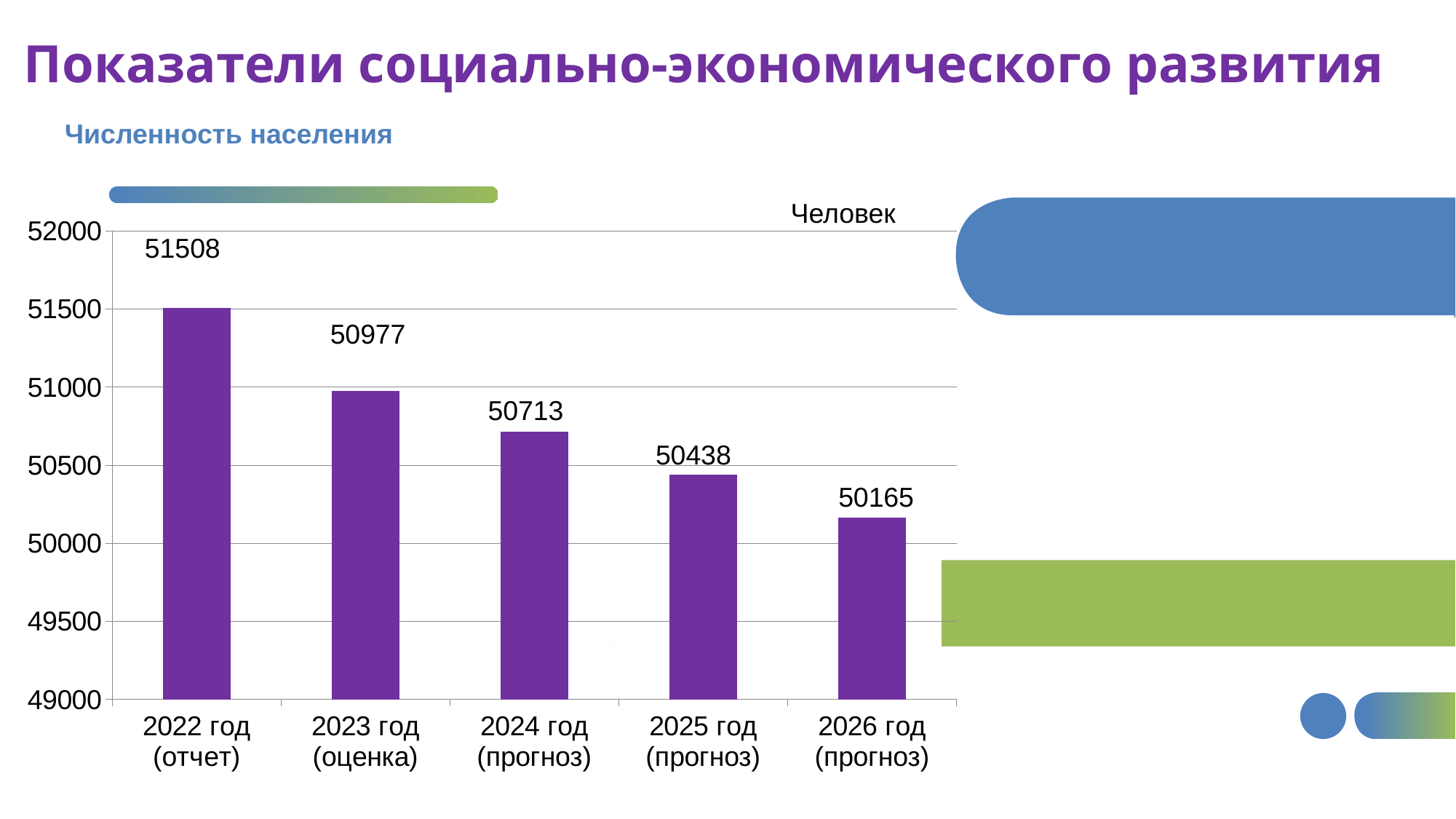
Which year has the highest population value on the chart? 2022 год (отчет) Is the value for 2024 год (прогноз) greater or less than 51000? less What is the difference between the population values for 2025 год (прогноз) and 2026 год (прогноз)? 273 What is the population value shown for 2024 год (прогноз)? 50713 What is the population value shown for 2026 год (прогноз)? 50165 Which is larger, the population value for 2023 год (оценка) or for 2025 год (прогноз)? 2023 год (оценка) What is the population value shown for 2022 год (отчет)? 51508 What is the difference between the population values for 2022 год (отчет) and 2023 год (оценка)? 531 Which year has the lowest population value on the chart? 2026 год (прогноз) What kind of chart is used to show the population figures? bar chart Do the population values rise or fall from 2022 to 2026? fall How many years (bars) are shown on the chart? 5